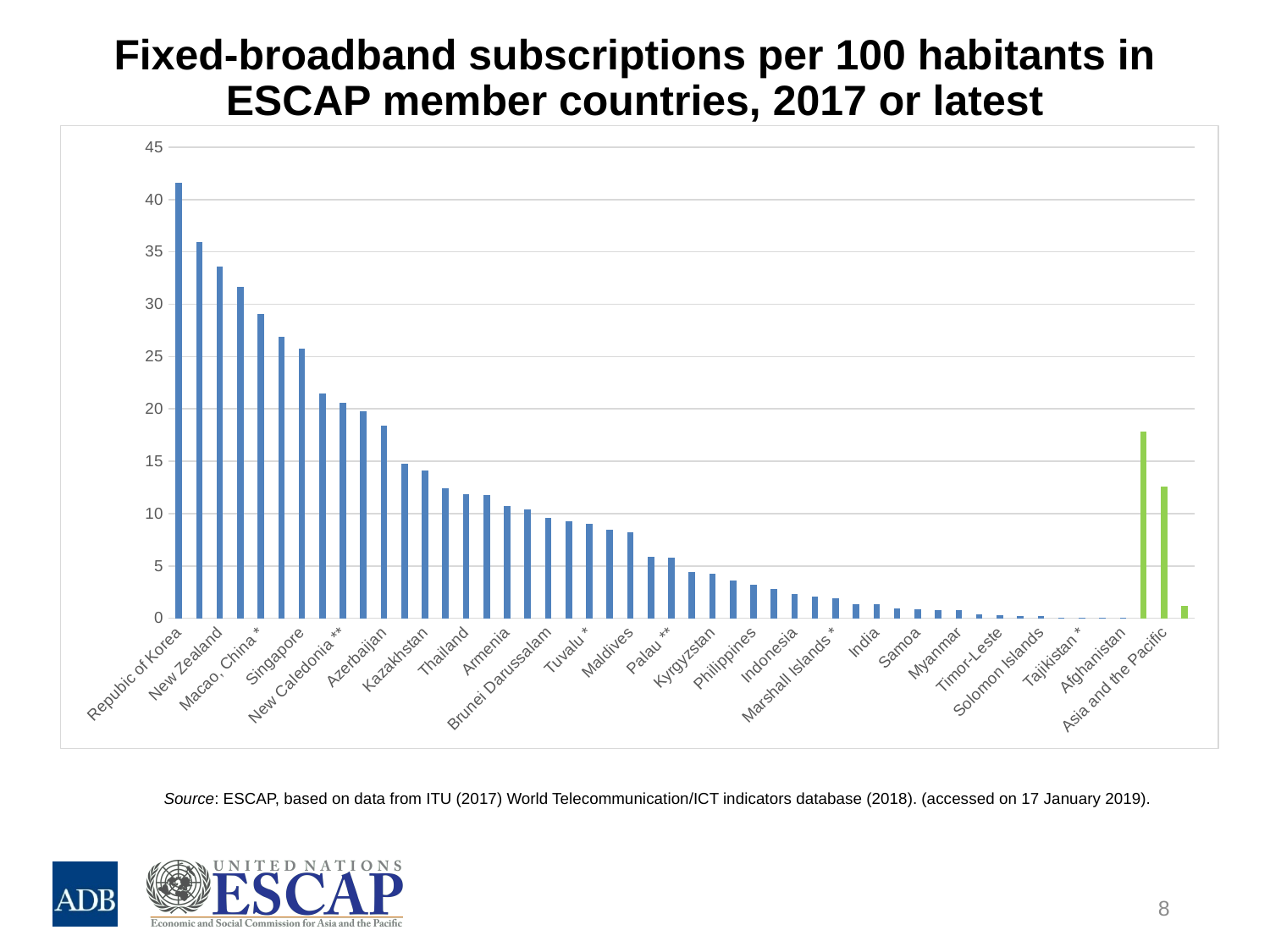
Which has a higher value, Republic of Korea or New Zealand? Republic of Korea Is the value for New Zealand greater or less than 35? less Is the value for Thailand greater or less than 10? greater Which country has the highest fixed-broadband subscriptions per 100 inhabitants? Republic of Korea What colour are the bars for Asia and the Pacific? green Is the value for Singapore greater or less than 25? greater What kind of chart is shown on the slide? bar chart Do the values of the blue bars rise or fall from left to right along the x axis? fall